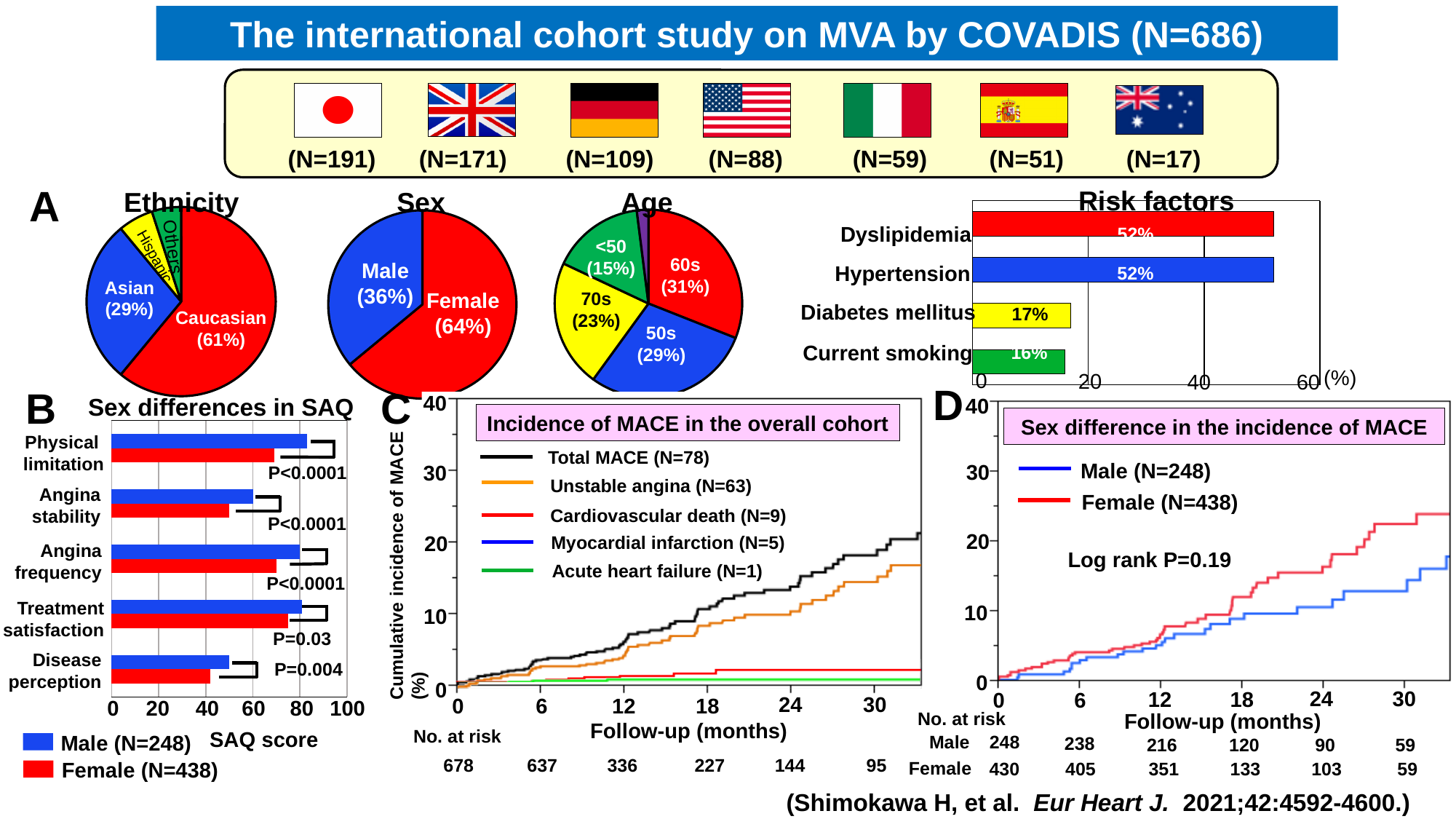
In the Sex differences in SAQ chart, which is larger for Angina stability, the Male or the Female score? Male In the Ethnicity pie chart, what share of the cohort is Caucasian? 61% What kind of chart is the Risk factors chart? Bar chart In the Age pie chart, which labelled age group has the largest share? 60s (31%) In the Risk factors chart, what is the value for Diabetes mellitus? 17% In the Risk factors chart, which risk factor has the lowest value? Current smoking (16%) In the Sex pie chart, what percentage of the cohort is Female? 64% In the Sex difference in the incidence of MACE chart, what is the log rank P value shown? P=0.19 How many series does the legend of the Incidence of MACE in the overall cohort chart list? 5 In the Age pie chart, what is the difference in percentage points between the 50s and 70s groups? 6 percentage points In the Risk factors chart, what is the difference between Hypertension and Current smoking? 36 percentage points